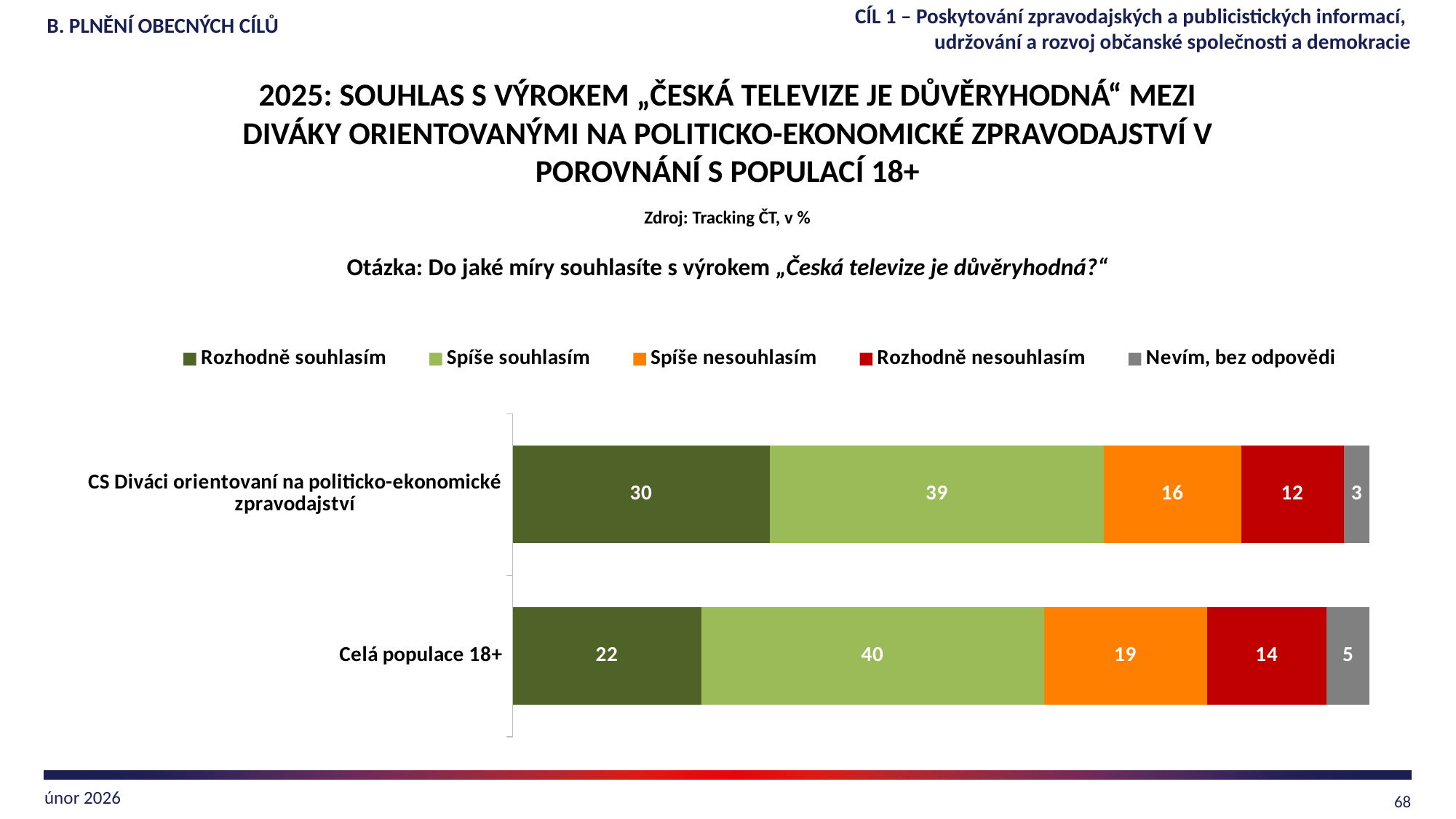
How many series does the legend list? 5 What is the value of "Rozhodně souhlasím" for "CS Diváci orientovaní na politicko-ekonomické zpravodajství"? 30 What is the value of "Nevím, bez odpovědi" for "Celá populace 18+"? 5 What is the difference between the "Rozhodně souhlasím" values for "CS Diváci orientovaní na politicko-ekonomické zpravodajství" and "Celá populace 18+"? 8 What is the value of "Rozhodně nesouhlasím" for "CS Diváci orientovaní na politicko-ekonomické zpravodajství"? 12 How many categories are shown on the chart? 2 What kind of chart is shown on the slide? Stacked bar chart What is the value of "Spíše souhlasím" for "Celá populace 18+"? 40 What is the difference between the "Rozhodně nesouhlasím" values for "Celá populace 18+" and "CS Diváci orientovaní na politicko-ekonomické zpravodajství"? 2 What is the total of the stacked bar for "CS Diváci orientovaní na politicko-ekonomické zpravodajství"? 100 Which series is shown in orange in the legend? Spíše nesouhlasím Which category has the higher value for "Spíše nesouhlasím"? Celá populace 18+